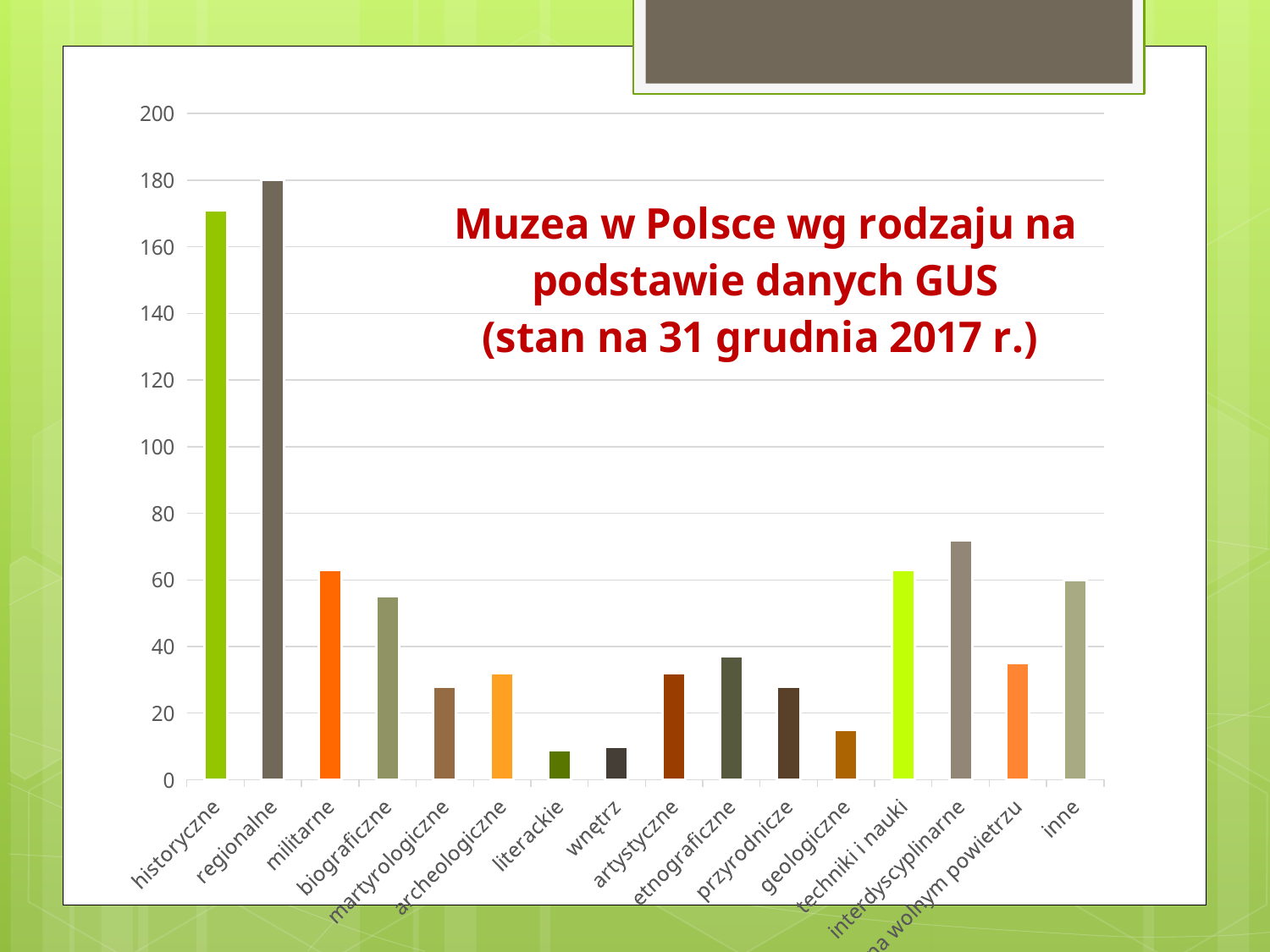
Which is larger, the value for regionalne or the value for historyczne? regionalne Which is larger, the value for etnograficzne or the value for geologiczne? etnograficzne Is the value for militarne greater or less than 80? less Is the value for interdyscyplinarne greater or less than 60? greater How many categories are shown on the x axis of the chart? 16 What kind of chart is shown on the slide? bar chart Is the value for historyczne greater or less than 160? greater Which category has the highest value in the chart? regionalne What is the title of the chart? Muzea w Polsce wg rodzaju na podstawie danych GUS (stan na 31 grudnia 2017 r.) Which is larger, the value for inne or the value for na wolnym powietrzu? inne